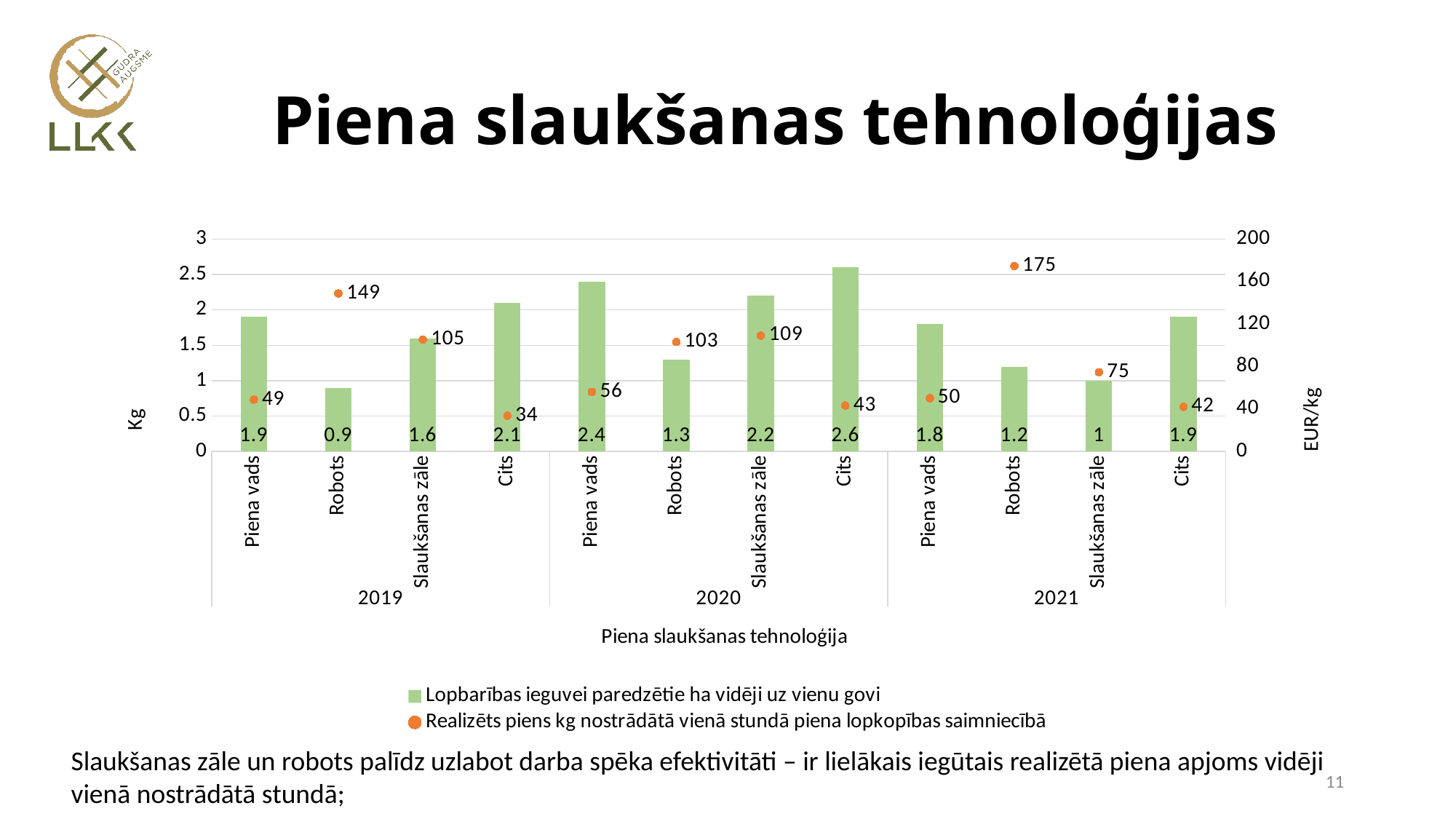
Which has a larger bar value: Piena vads in 2020 or Piena vads in 2021? Piena vads in 2020 What is the bar value for Cits in 2020? 2.6 Which category and year has the highest bar value? Cits, 2020 What kind of chart is this? Combined bar and dot (scatter) chart What is the difference between the bar values for Slaukšanas zāle in 2020 and Slaukšanas zāle in 2021? 1.2 How many series does the legend list? 2 What is the value of Realizēts piens kg nostrādātā vienā stundā for Robots in 2021? 175 What is the label of the right-hand vertical axis? EUR/kg What is the bar value (Lopbarības ieguvei paredzētie ha vidēji uz vienu govi) for Robots in 2019? 0.9 How many bars are plotted in the chart? 12 Which category and year has the lowest Realizēts piens value (orange dot)? Cits, 2019 What is the difference between the Realizēts piens values for Robots in 2021 and Robots in 2019? 26